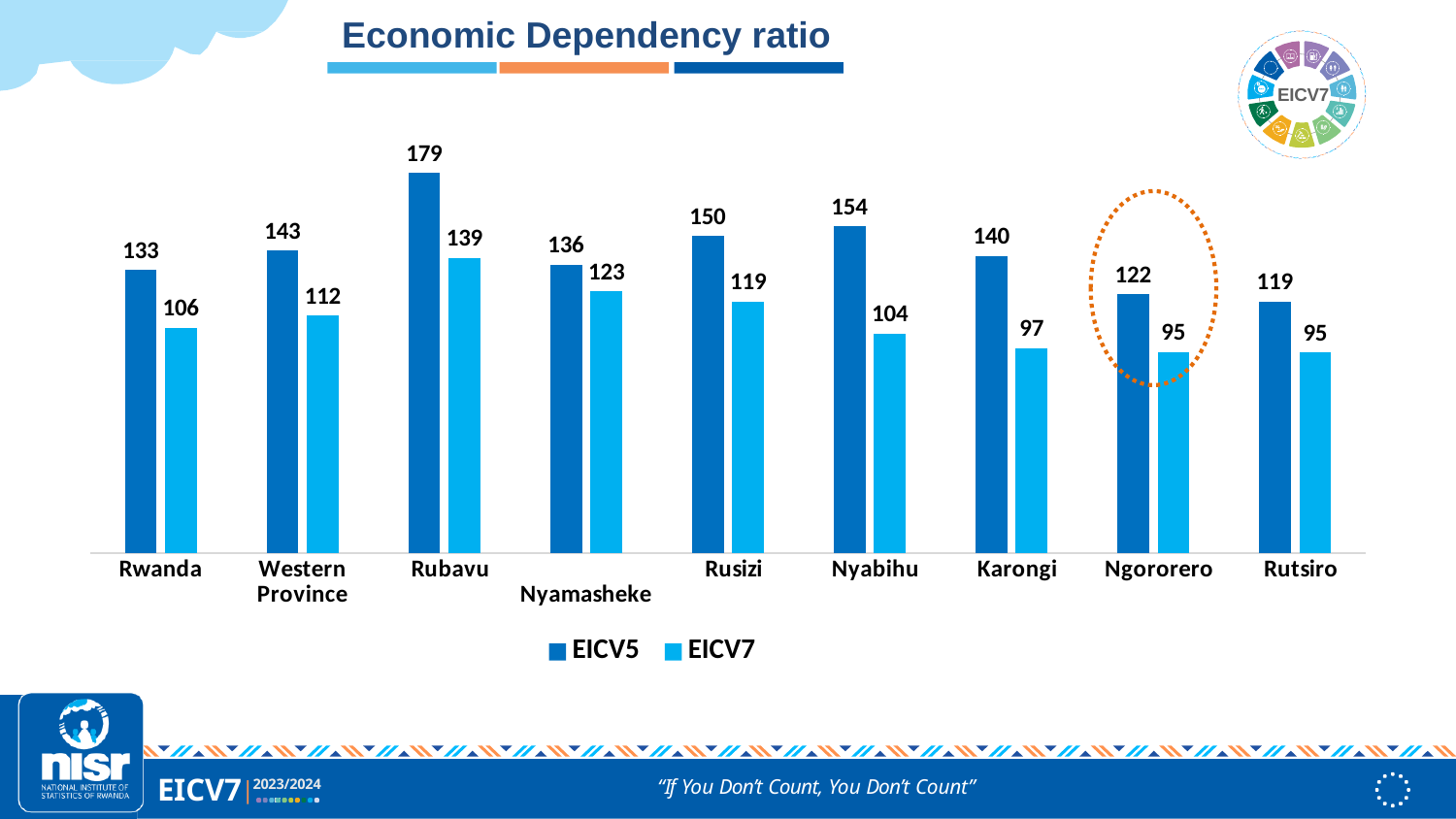
What is the EICV7 economic dependency ratio for Nyamasheke? 123 How many series does the legend list? 2 Which is larger, the EICV7 value for Rusizi or the EICV7 value for Nyabihu? Rusizi How many categories are shown on the x axis of the chart? 9 What type of chart is shown on the slide? Bar chart What is the EICV7 value for Karongi? 97 What is the EICV5 economic dependency ratio for Rwanda? 133 What is the difference between the EICV5 and EICV7 values for Nyabihu? 50 What is the difference between the EICV5 values for Rubavu and Rwanda? 46 Which category has the lowest EICV5 economic dependency ratio? Rutsiro Which district or region has the highest EICV5 economic dependency ratio? Rubavu Which category has the highest EICV7 economic dependency ratio? Rubavu